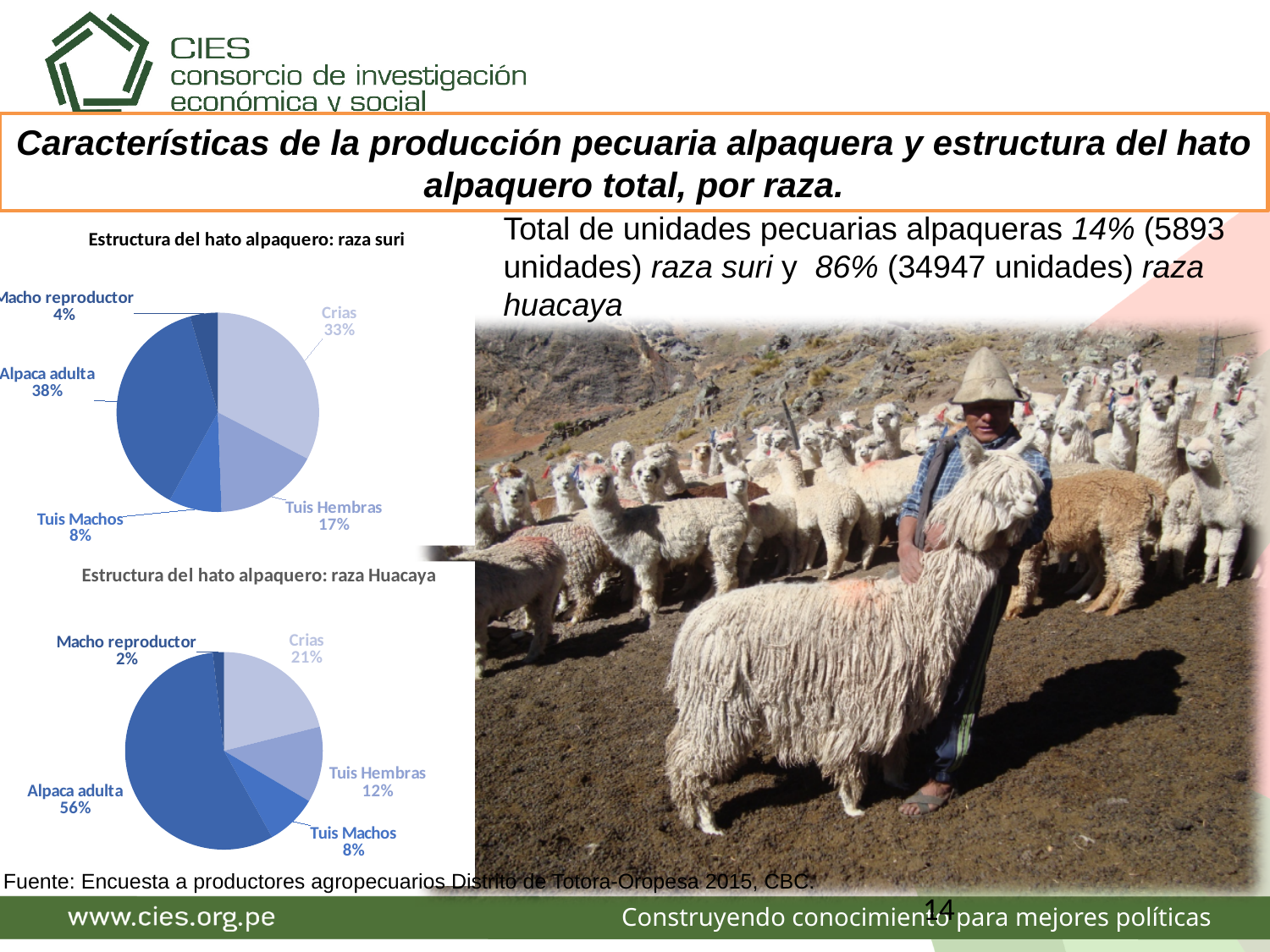
In the chart 'Estructura del hato alpaquero: raza suri', what is the difference in percentage points between Crias and Tuis Hembras? 16 In the chart 'Estructura del hato alpaquero: raza Huacaya', which is larger, Crias or Tuis Machos? Crias In the chart 'Estructura del hato alpaquero: raza suri', what share is Crias? 33% In the chart 'Estructura del hato alpaquero: raza Huacaya', what share is Tuis Hembras? 12% In the chart 'Estructura del hato alpaquero: raza suri', which category has the largest share? Alpaca adulta In the chart 'Estructura del hato alpaquero: raza suri', which category has the smallest share? Macho reproductor In the chart 'Estructura del hato alpaquero: raza suri', what share is Alpaca adulta? 38% In the chart 'Estructura del hato alpaquero: raza Huacaya', which category has the smallest share? Macho reproductor What type of chart is 'Estructura del hato alpaquero: raza suri'? Pie chart How many categories does the chart 'Estructura del hato alpaquero: raza Huacaya' show? 5 In the chart 'Estructura del hato alpaquero: raza Huacaya', what share is Alpaca adulta? 56% What is the difference in percentage points between the Alpaca adulta share in the raza Huacaya chart and the Alpaca adulta share in the raza suri chart? 18